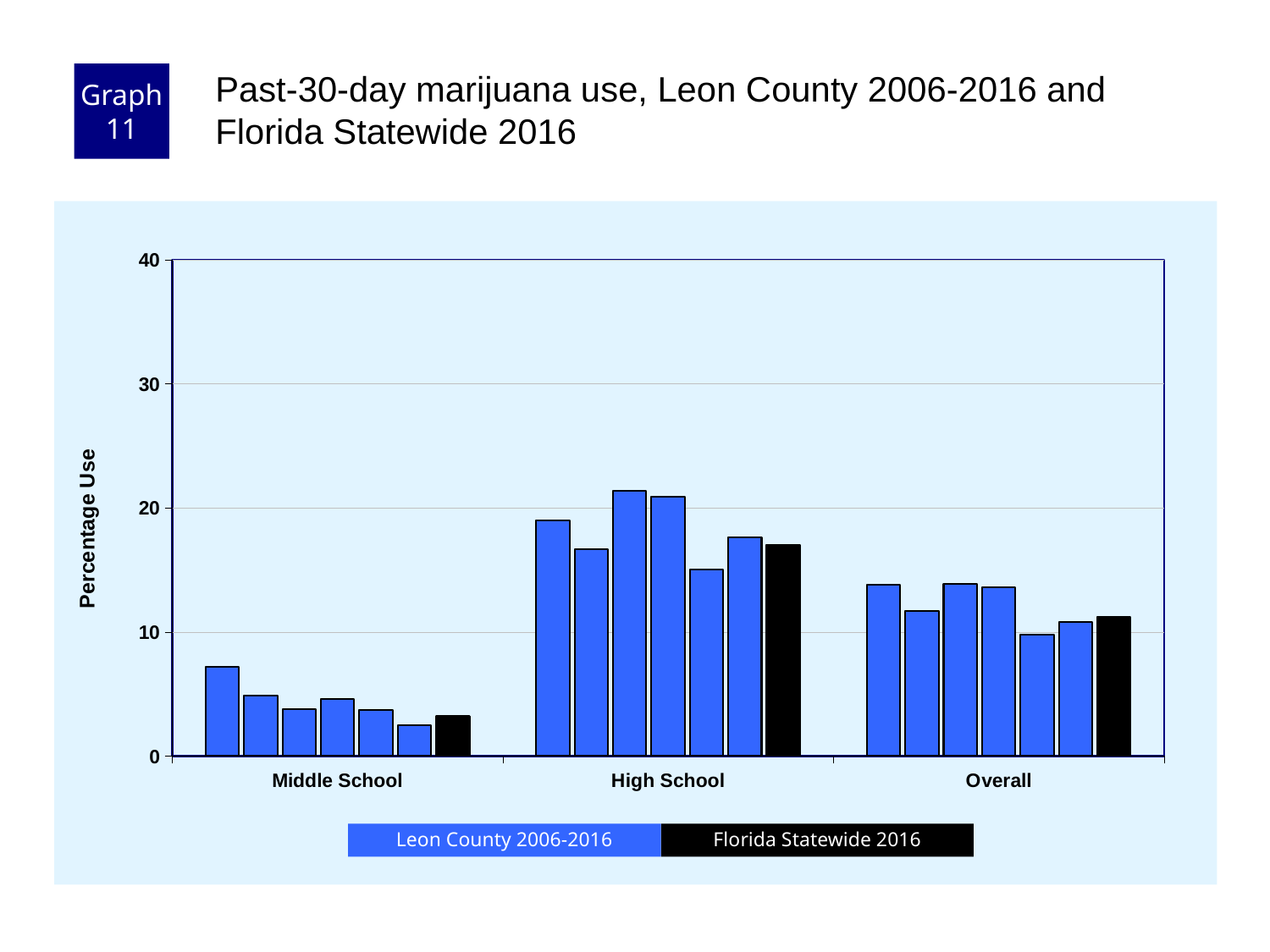
Is the Florida Statewide 2016 value for Overall greater or less than 20? less How many series does the legend list? 2 What is the label on the y axis? Percentage Use How many categories are shown on the x axis? 3 Do the Leon County 2006-2016 bars for Middle School generally rise or fall from left to right? fall Is the Florida Statewide 2016 value for Middle School greater or less than 10? less Is the Florida Statewide 2016 value for High School greater or less than 20? less Which category has the highest bars overall? High School Which category has the lowest bars overall? Middle School What kind of chart is shown on the slide? bar chart Which is larger, the Florida Statewide 2016 value for High School or for Middle School? High School